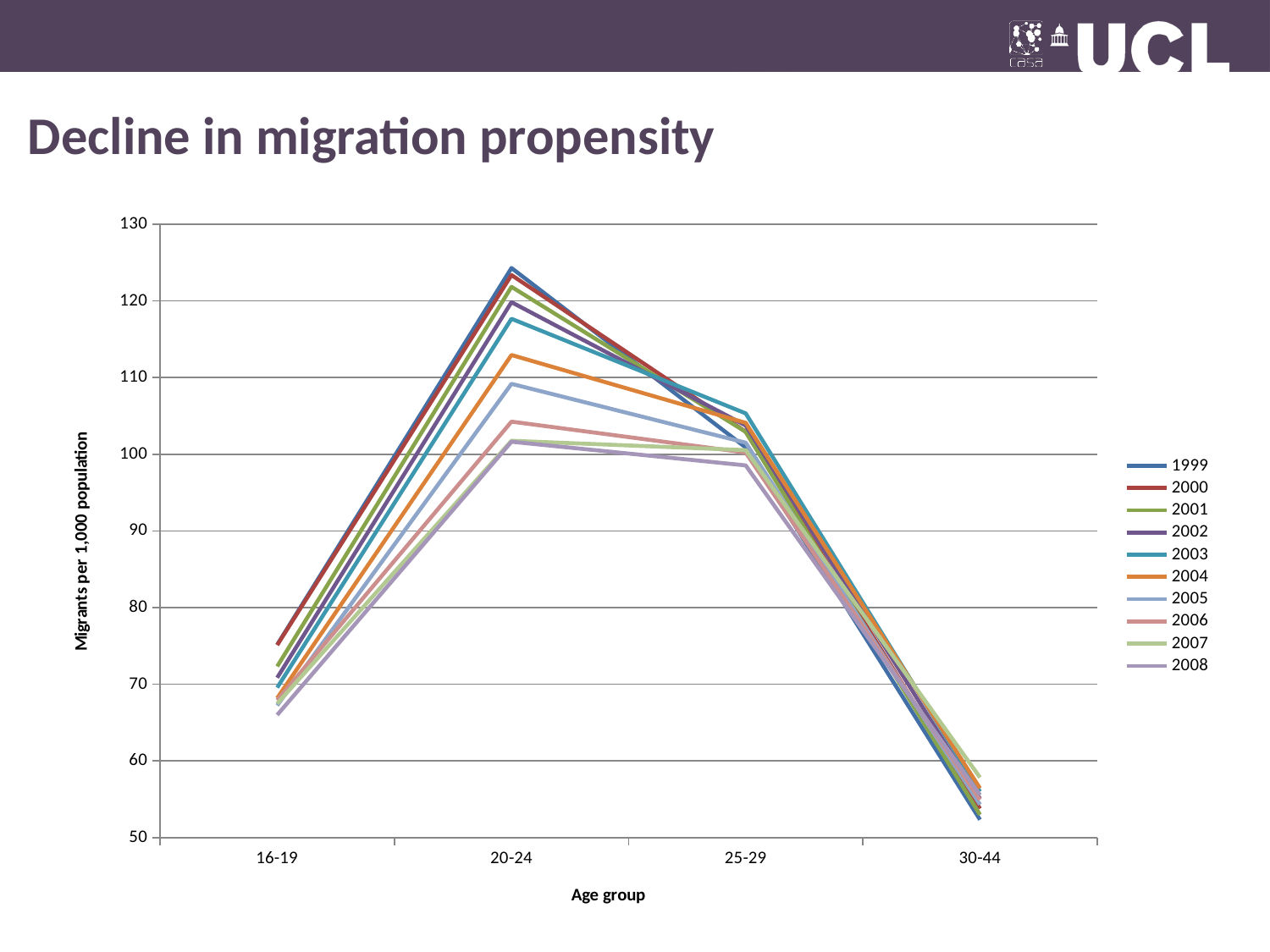
What is the title of the vertical axis? Migrants per 1,000 population Is the value for 2008 at age group 16-19 greater or less than 70? less Do the values for the 2000 series rise or fall from age group 20-24 to 30-44? fall What kind of chart is shown on the slide? line chart How many series does the legend list? 10 Is the value for 2008 at age group 20-24 greater or less than 110? less At age group 20-24, which series has the larger value, 1999 or 2008? 1999 For the 2008 series, which age group has the lowest value? 30-44 For the 1999 series, which age group has the highest value? 20-24 Is the value for 1999 at age group 30-44 greater or less than 60? less How many age groups are shown on the x axis? 4